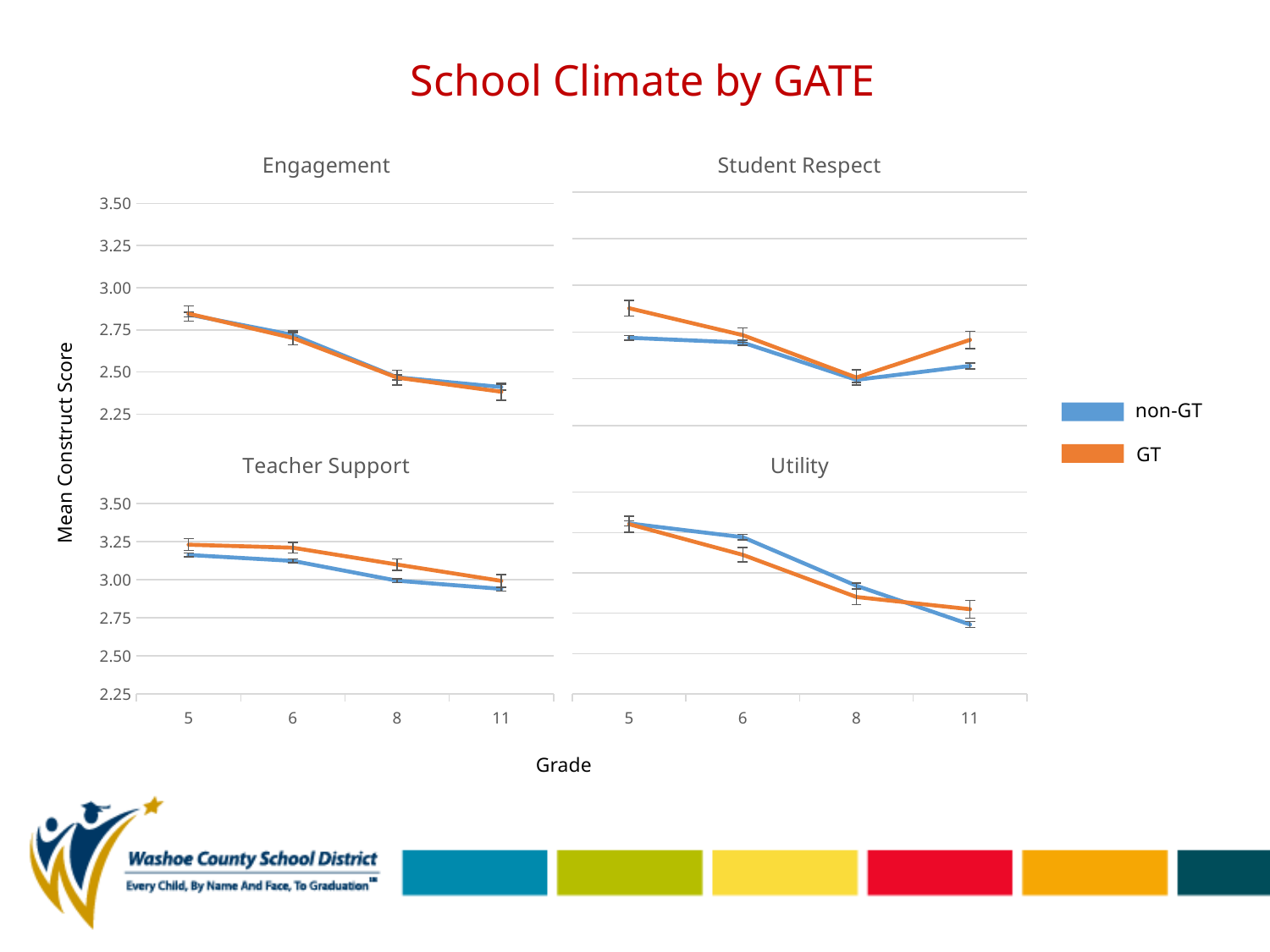
In the Teacher Support chart, is the GT value at grade 5 greater or less than 3.00? greater How many series does the legend list? 2 What is the label on the shared y axis of the charts? Mean Construct Score In the Utility chart, is the non-GT value at grade 11 greater or less than 3.00? less In the Utility chart, how many grade levels are plotted along the x axis? 4 In the Student Respect chart, at grade 11, which series has the higher value, GT or non-GT? GT In the Student Respect chart, at which grade is the GT value lowest? 8 In the Engagement chart, do the non-GT values rise or fall from grade 5 to grade 11? fall In the Engagement chart, is the GT value at grade 5 greater or less than 2.75? greater What kind of chart is used in the Engagement panel? line chart In the Utility chart, at which grade is the non-GT value highest? 5 In the Utility chart, at grade 6, which series has the higher value, GT or non-GT? non-GT